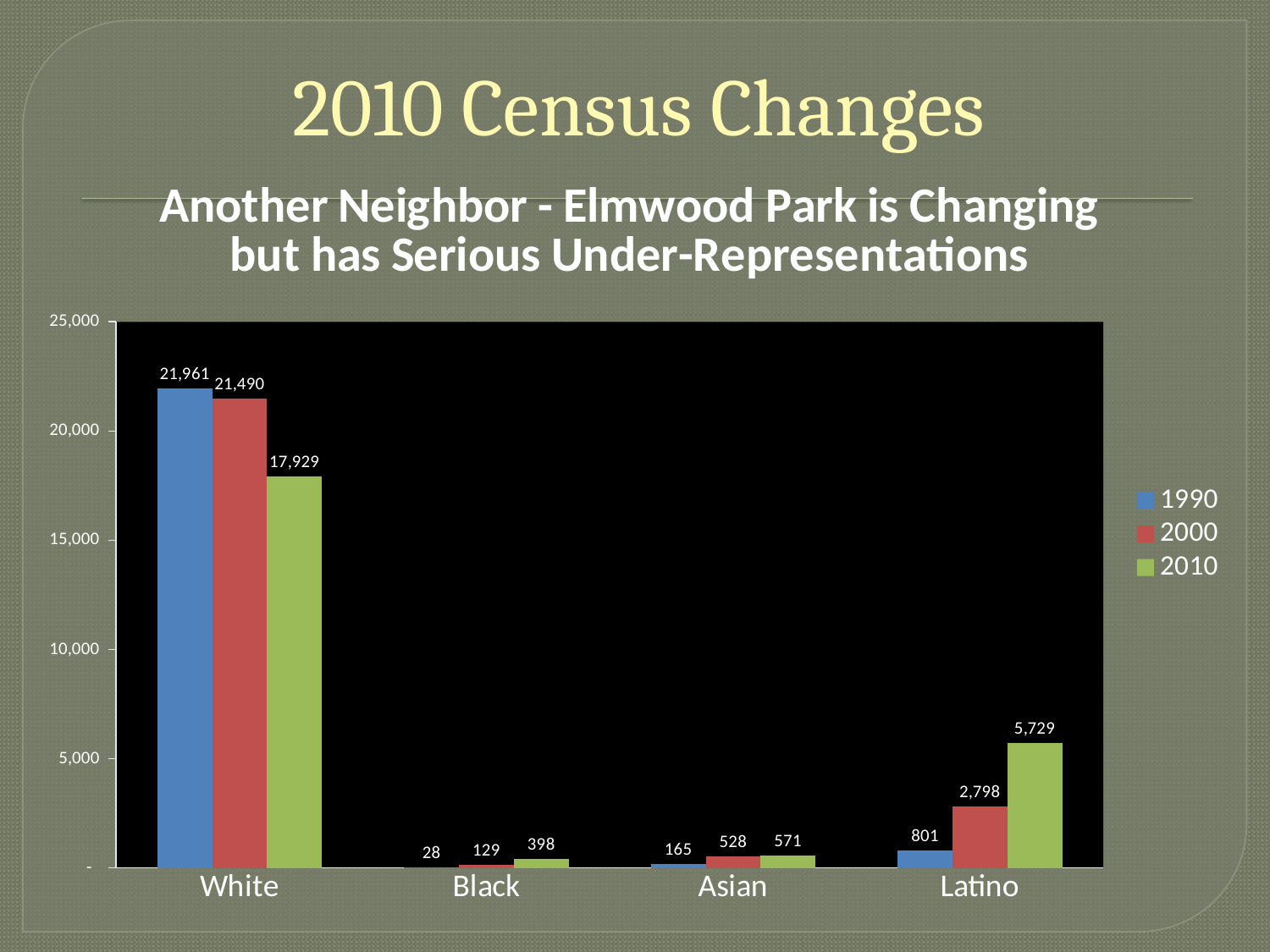
Do the Latino values rise or fall from 1990 to 2010? Rise What is the value for Asian in 2010? 571 What is the difference between the White values for 1990 and 2010? 4,032 What is the value for White in 1990? 21,961 Which category has the highest value in 2010? White What kind of chart is shown on the slide? Bar chart How many series does the legend list? 3 Which is larger, the Latino value in 2000 or the Asian value in 2010? Latino in 2000 What is the value for Black in 2000? 129 Which category has the lowest value in 1990? Black How many categories are shown on the x axis? 4 What is the value for Latino in 2010? 5,729